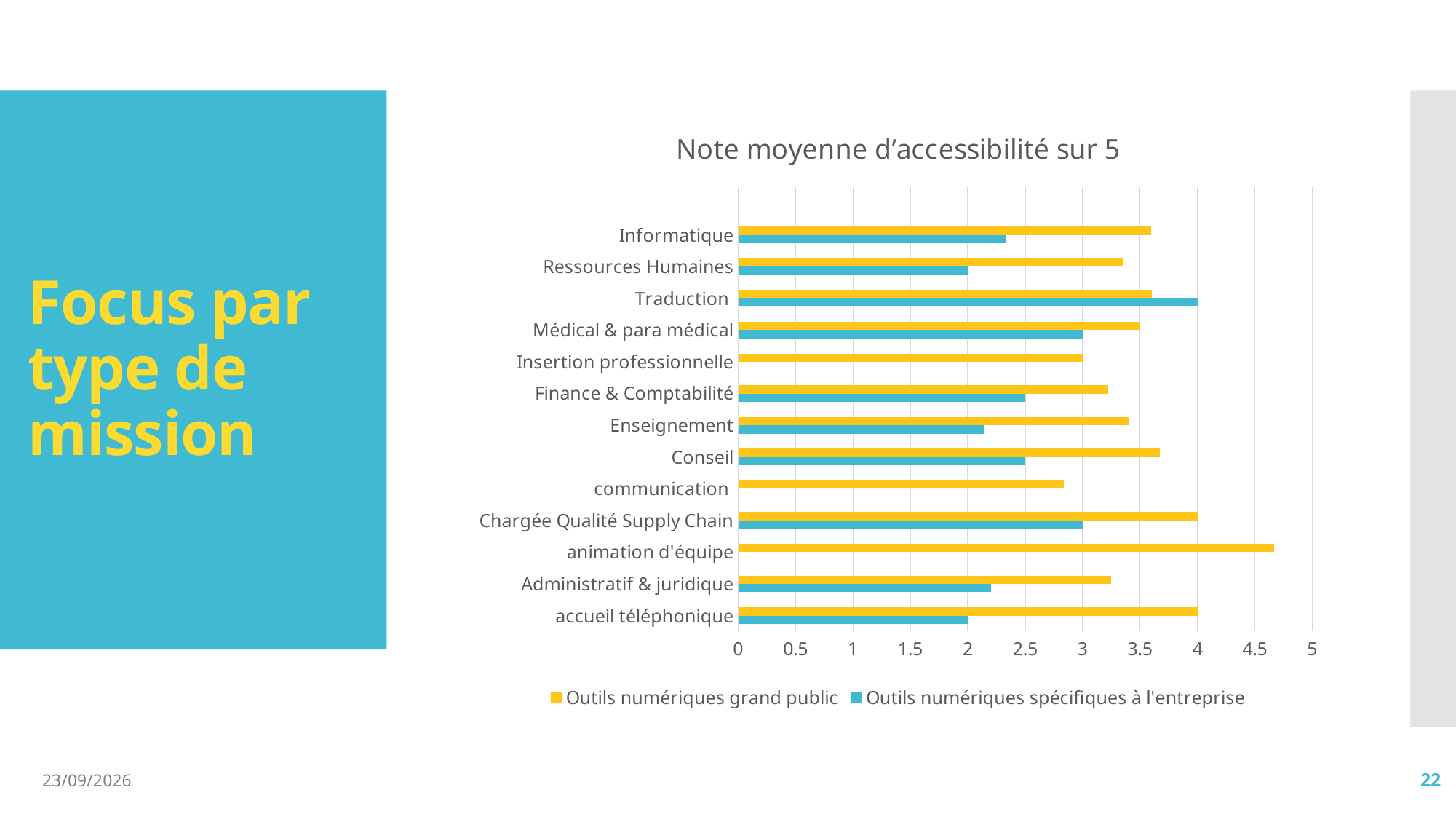
What is the title of the chart? Note moyenne d'accessibilité sur 5 How many series does the legend list? 2 What is the value of 'Outils numériques spécifiques à l'entreprise' for Traduction? 4 What is the value of 'Outils numériques grand public' for accueil téléphonique? 4 Which category has the lowest value for 'Outils numériques grand public'? communication What is the value of 'Outils numériques spécifiques à l'entreprise' for Chargée Qualité Supply Chain? 3 What is the difference between 'Outils numériques grand public' and 'Outils numériques spécifiques à l'entreprise' for accueil téléphonique? 2 Which category has the highest value for 'Outils numériques grand public'? animation d'équipe How many mission categories are shown on the chart? 13 For Traduction, which series has the larger value? Outils numériques spécifiques à l'entreprise What type of chart is shown on the slide? bar chart Is the value of 'Outils numériques grand public' for Informatique greater or less than 3.5? greater